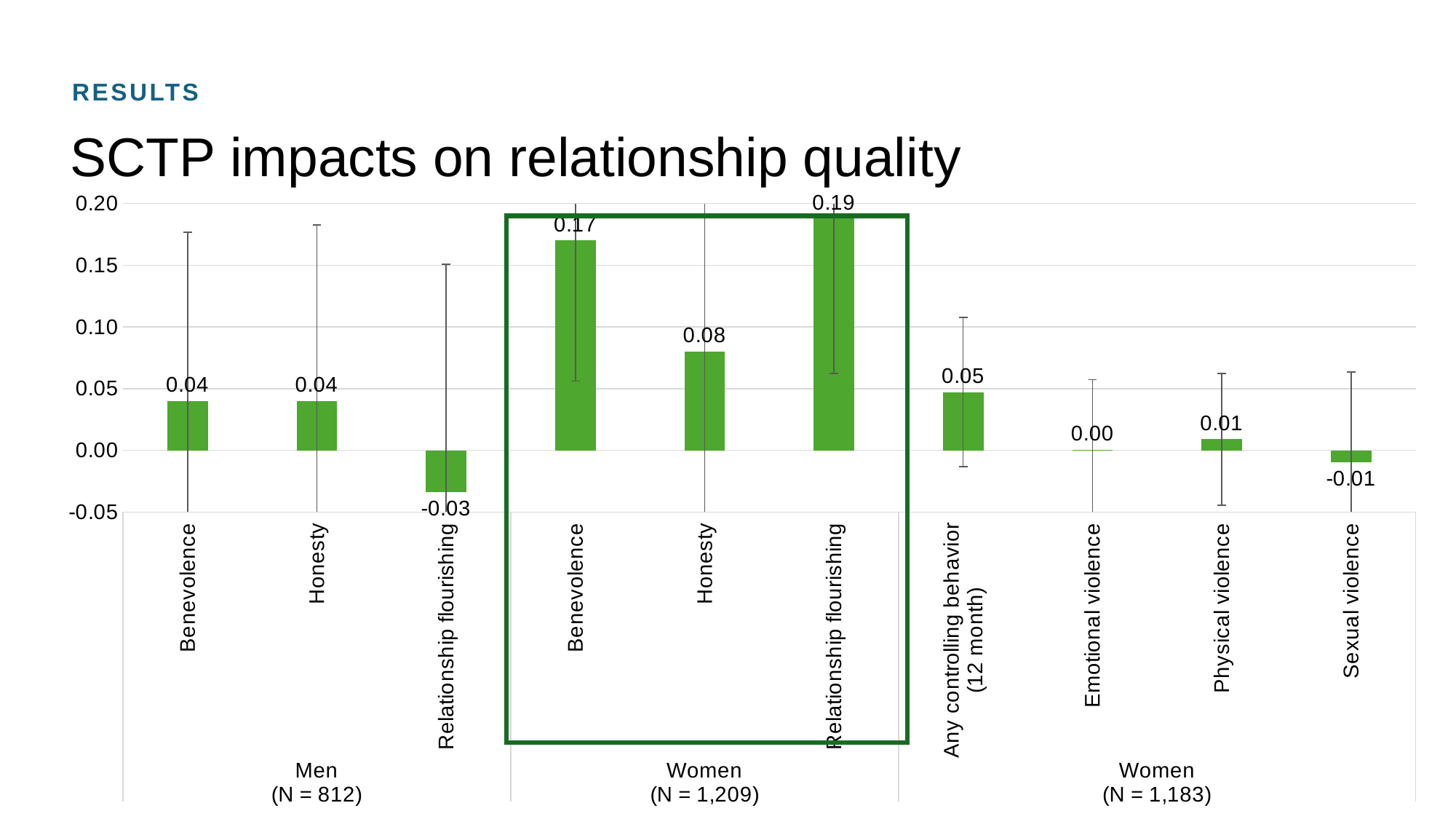
What is the value for Benevolence in the Women (N = 1,209) group? 0.17 What is the value for Relationship flourishing in the Men (N = 812) group? -0.03 What is the value for Any controlling behavior (12 month) in the Women (N = 1,183) group? 0.05 What kind of chart is shown on the slide? Bar chart Which category has the lowest value on the chart? Relationship flourishing (Men, N = 812) How many categories (bars) are shown on the chart? 10 What is the difference between the Relationship flourishing values for Women (N = 1,209) and Men (N = 812)? 0.22 Which is larger: Honesty for Men (N = 812) or Honesty for Women (N = 1,209)? Honesty for Women (N = 1,209) What is the sample size shown for the Men group? N = 812 Which category has the highest value on the chart? Relationship flourishing (Women, N = 1,209) What is the value for Sexual violence? -0.01 What is the title of the chart? SCTP impacts on relationship quality